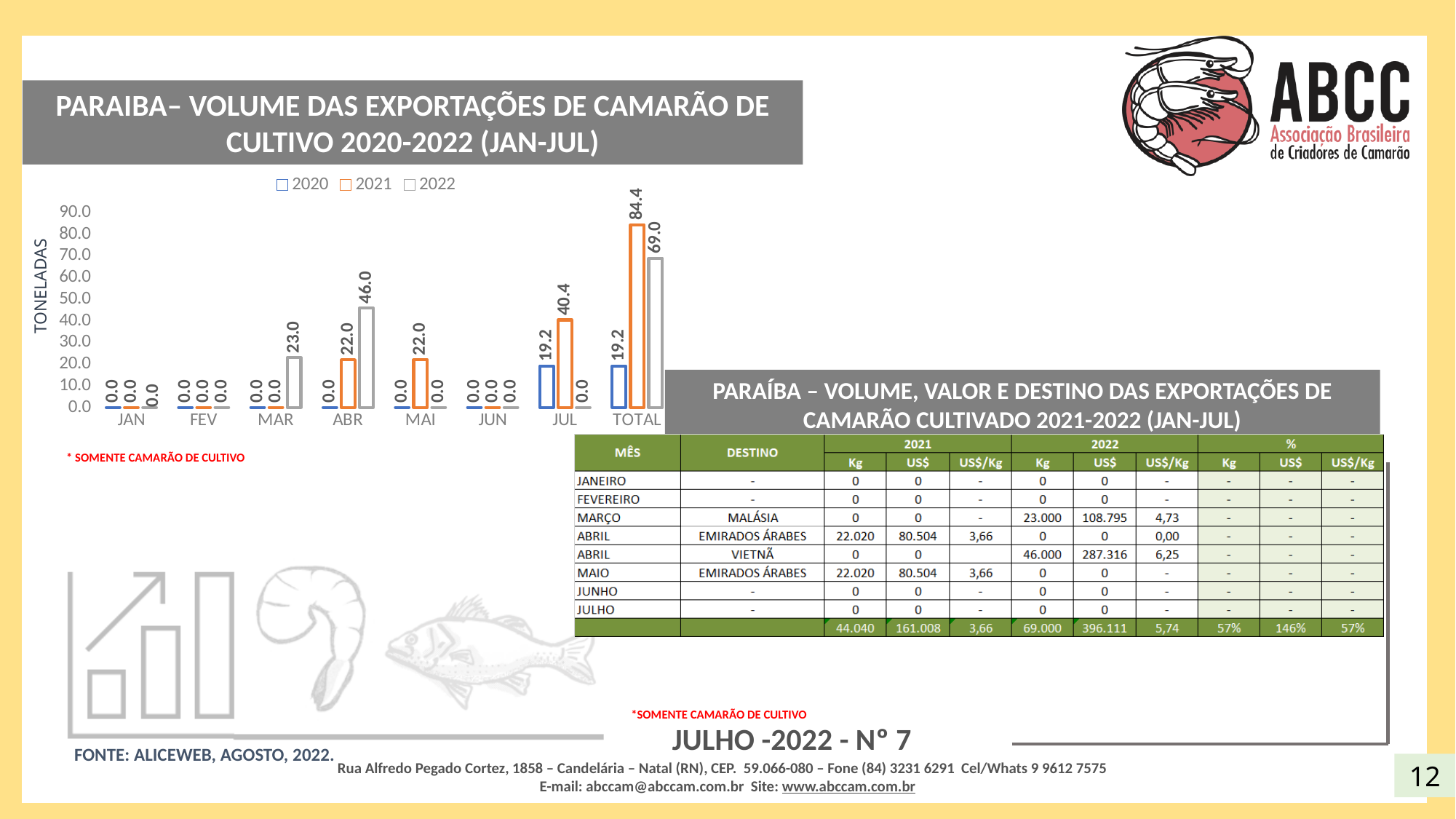
How many series does the chart legend list? 3 What is the difference between the 2021 and 2022 TOTAL values? 15.4 What is the value for 2022 in MAR? 23.0 What is the value for 2021 in JUL? 40.4 What is the difference between the 2021 and 2020 values in JUL? 21.2 Which year has the highest TOTAL value? 2021 What is the TOTAL value for 2020? 19.2 What is the value for 2022 in ABR? 46.0 How many categories are shown on the x axis of the chart? 8 What unit is shown on the y axis of the chart? TONELADAS What type of chart is shown on the slide? bar chart Which is larger in ABR, the value for 2021 or the value for 2022? 2022